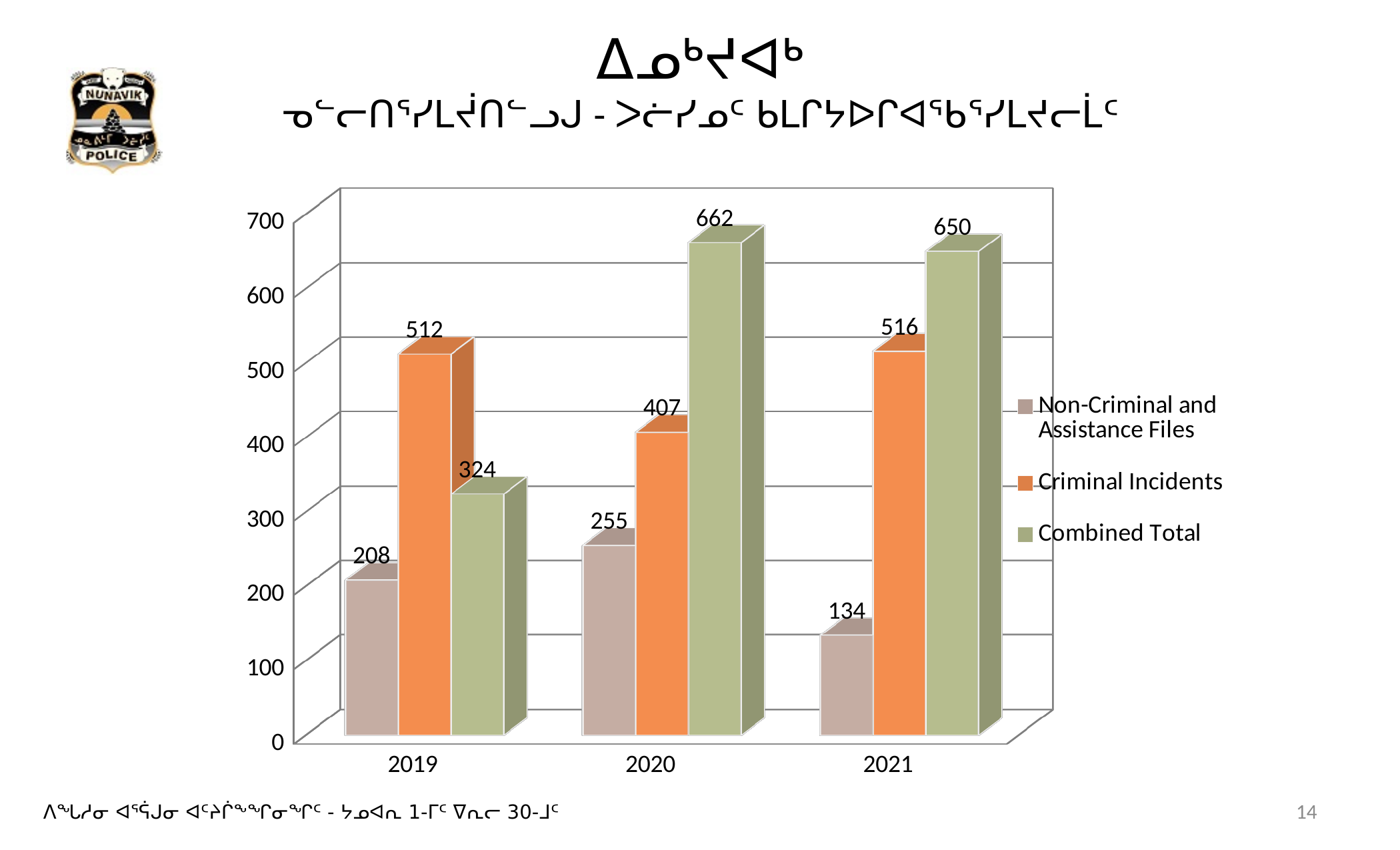
Which colour represents Combined Total in the legend? Green How many series does the legend list? 3 What is the value for Combined Total in 2020? 662 What is the value for Criminal Incidents in 2020? 407 What is the difference between Criminal Incidents in 2021 and in 2020? 109 Which year has the highest Combined Total? 2020 Which year has the lowest value for Non-Criminal and Assistance Files? 2021 Which is larger: Combined Total in 2019 or Criminal Incidents in 2019? Criminal Incidents in 2019 What is the value for Non-Criminal and Assistance Files in 2021? 134 What kind of chart is shown on the slide? Bar chart How many years are shown on the x axis? 3 What is the value for Criminal Incidents in 2019? 512